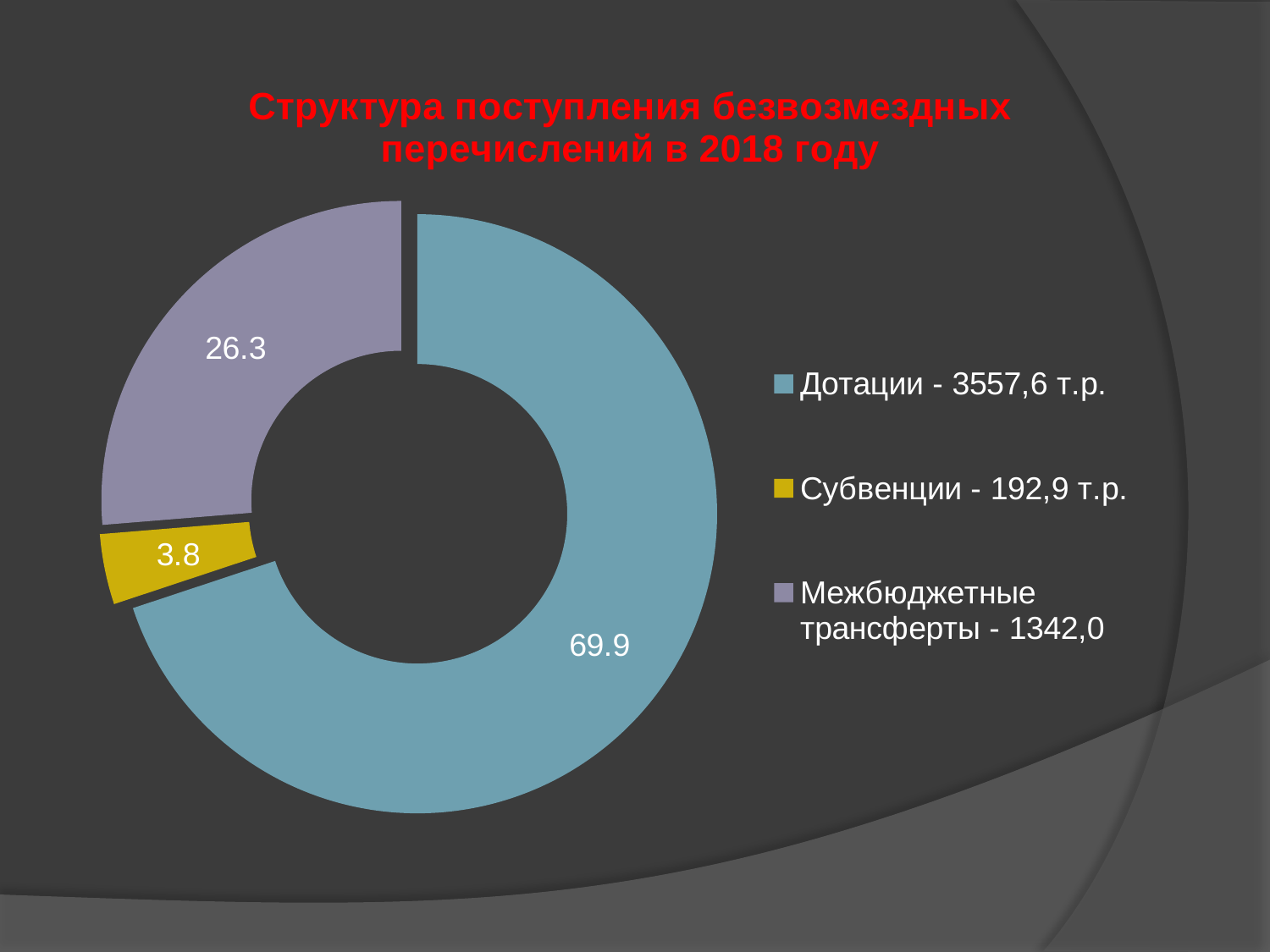
Which category has the smallest slice? Субвенции What is the title of the chart? Структура поступления безвозмездных перечислений в 2018 году What kind of chart is shown on the slide? Doughnut (pie) chart What percentage label is shown on the Межбюджетные трансферты slice? 26.3 How many slices does the chart have? 3 Which category has the largest slice? Дотации What is the difference between the percentage labels for Дотации and Межбюджетные трансферты? 43.6 What amount is given for Дотации in the legend? 3557,6 т.р. What percentage label is shown on the Дотации slice? 69.9 How many entries does the legend list? 3 What percentage label is shown on the Субвенции slice? 3.8 What amount is given for Межбюджетные трансферты in the legend? 1342,0